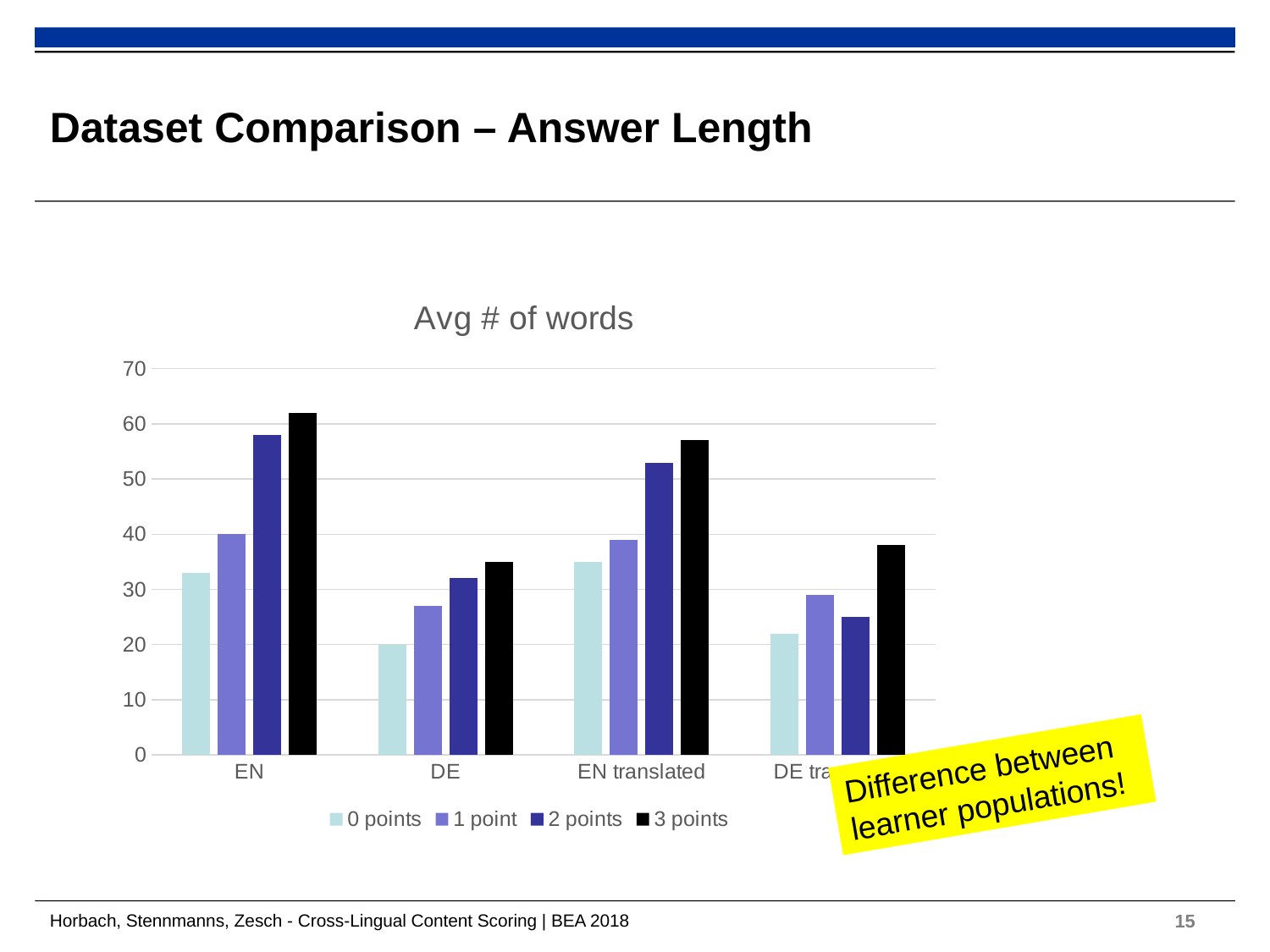
Which is larger, the 1 point value for EN translated or the 1 point value for DE? EN translated What is the title of the chart? Avg # of words Which category has the highest value for the 3 points series? EN How many categories are shown on the x axis? 4 What kind of chart is shown on the slide? bar chart Within the EN category, which series has the lowest value? 0 points Is the value for 2 points in the EN category greater or less than 50? greater Within the DE category, do the values rise or fall from 0 points to 3 points? rise How many series does the legend list? 4 Which series is shown in black in the legend? 3 points Is the value for 3 points in the DE category greater or less than 40? less Is the value for 0 points in the EN translated category greater or less than 30? greater